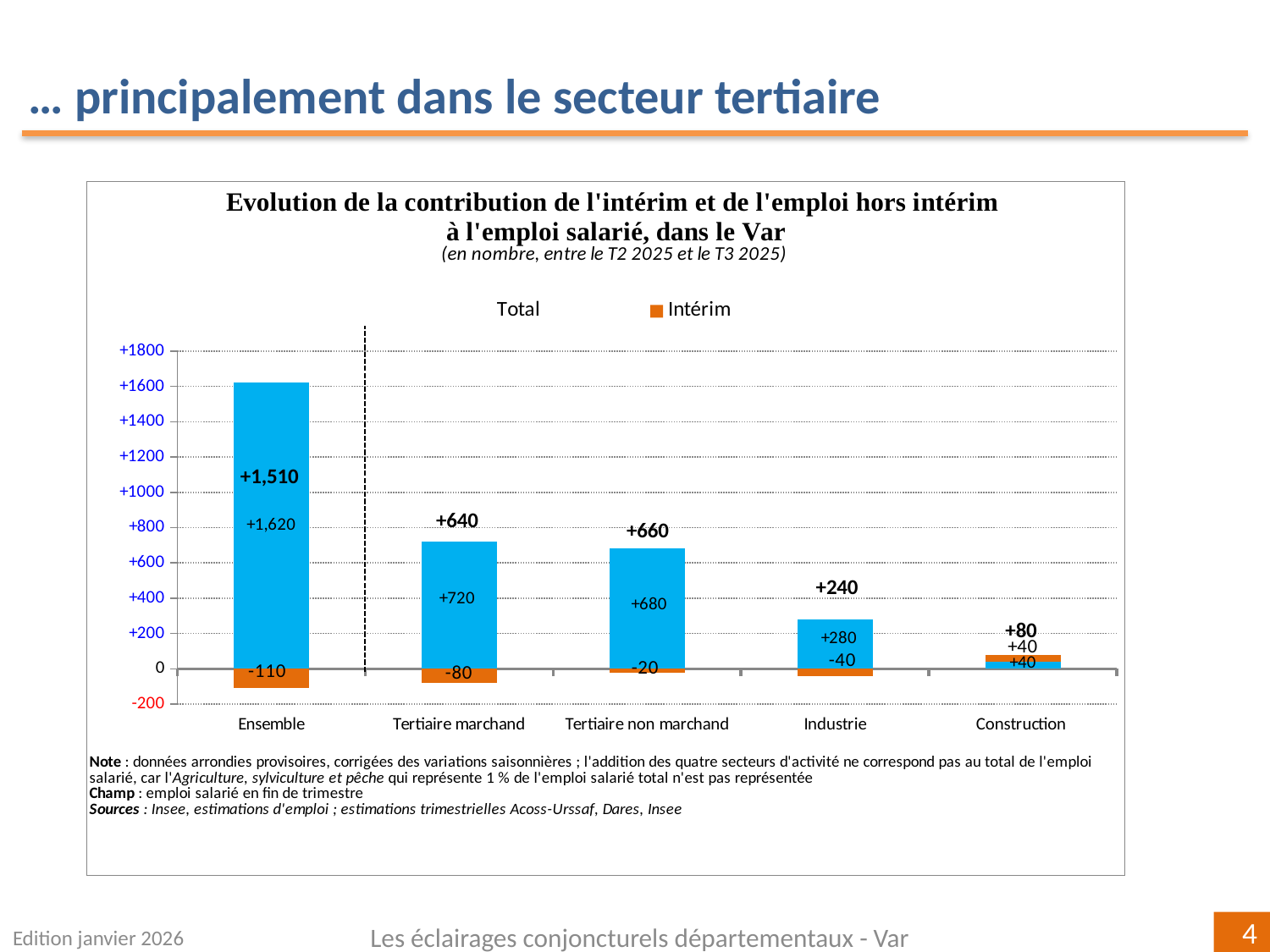
What is the Intérim value for Construction? +40 What is the total value shown for Industrie? +240 What is the Intérim value for Tertiaire marchand? -80 What type of chart is shown? Bar chart Which category has the lowest total value? Construction What is the value of the blue bar for Ensemble? +1,620 Which category has the highest total value? Ensemble What is the total value shown for Tertiaire non marchand? +660 What is the difference between the total for Tertiaire non marchand and the total for Tertiaire marchand? 20 Which is larger, the blue bar value for Tertiaire marchand or for Tertiaire non marchand? Tertiaire marchand How many categories are shown on the x axis? 5 What is the Intérim value for Ensemble? -110